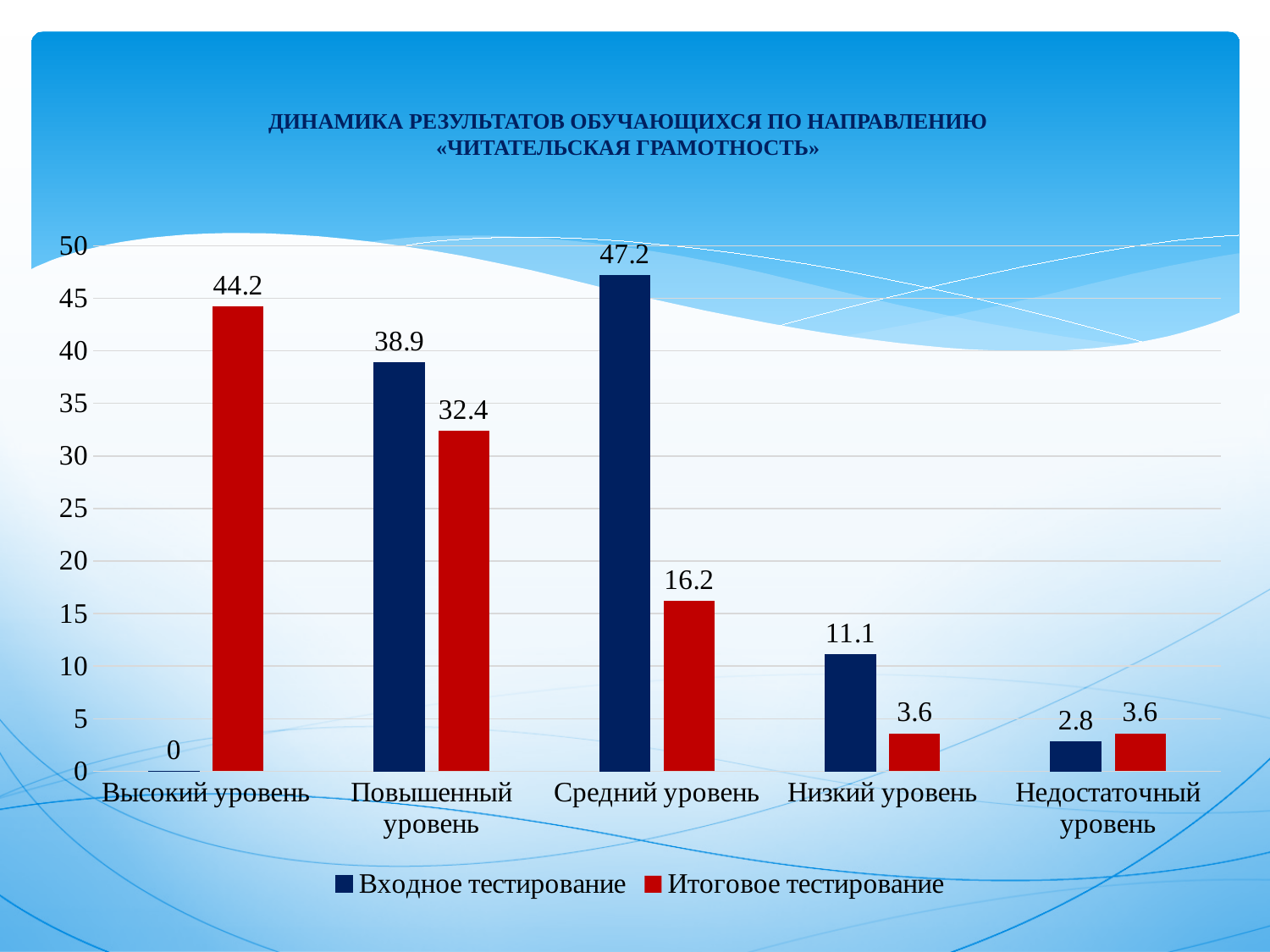
Which category has the lowest value in the Итоговое тестирование series? Низкий уровень and Недостаточный уровень (both 3.6) What is the value for Средний уровень in the Входное тестирование series? 47.2 What is the value for Низкий уровень in the Итоговое тестирование series? 3.6 What is the difference between the Входное тестирование and Итоговое тестирование values for Средний уровень? 31 Which category has the highest value in the Входное тестирование series? Средний уровень What is the value for Высокий уровень in the Итоговое тестирование series? 44.2 Which colour represents the Итоговое тестирование series? Red How many categories are shown on the x axis? 5 What is the difference between the Итоговое тестирование values for Высокий уровень and Повышенный уровень? 11.8 How many series does the legend list? 2 What kind of chart is shown on the slide? Bar chart For Повышенный уровень, which is larger: Входное тестирование or Итоговое тестирование? Входное тестирование